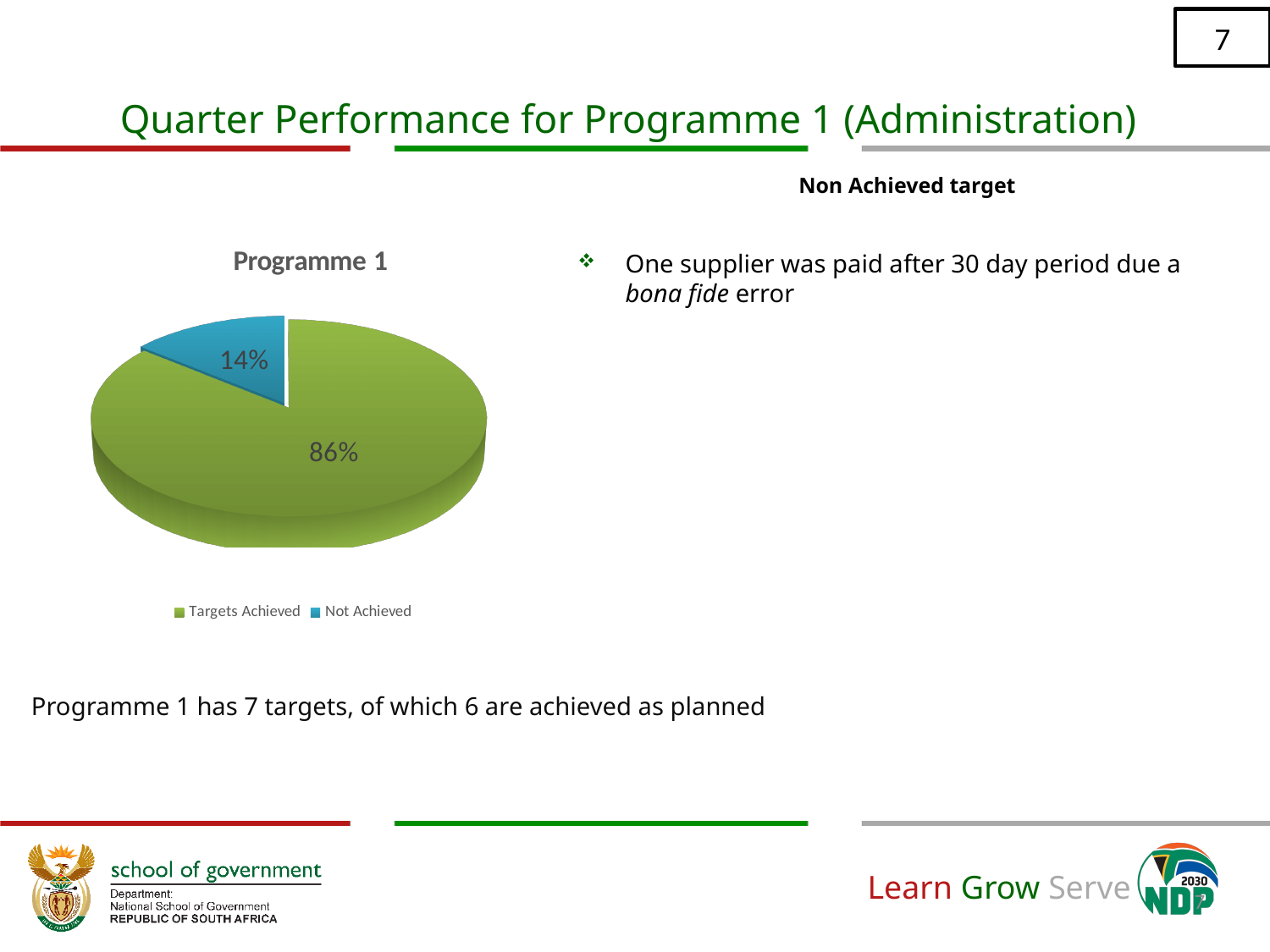
What is the title of the chart? Programme 1 What percentage of the pie is labelled Not Achieved? 14% Which is larger, the Targets Achieved slice or the Not Achieved slice? Targets Achieved What colour is the Not Achieved slice? blue Which slice of the pie is the smallest? Not Achieved How many entries does the legend list? 2 What type of chart is shown on the slide? pie chart What percentage of the pie is labelled Targets Achieved? 86% What share of the pie does the Targets Achieved slice represent? 86% Which slice of the pie is the largest? Targets Achieved How many slices does the pie chart have? 2 What is the difference in percentage points between the Targets Achieved slice and the Not Achieved slice? 72